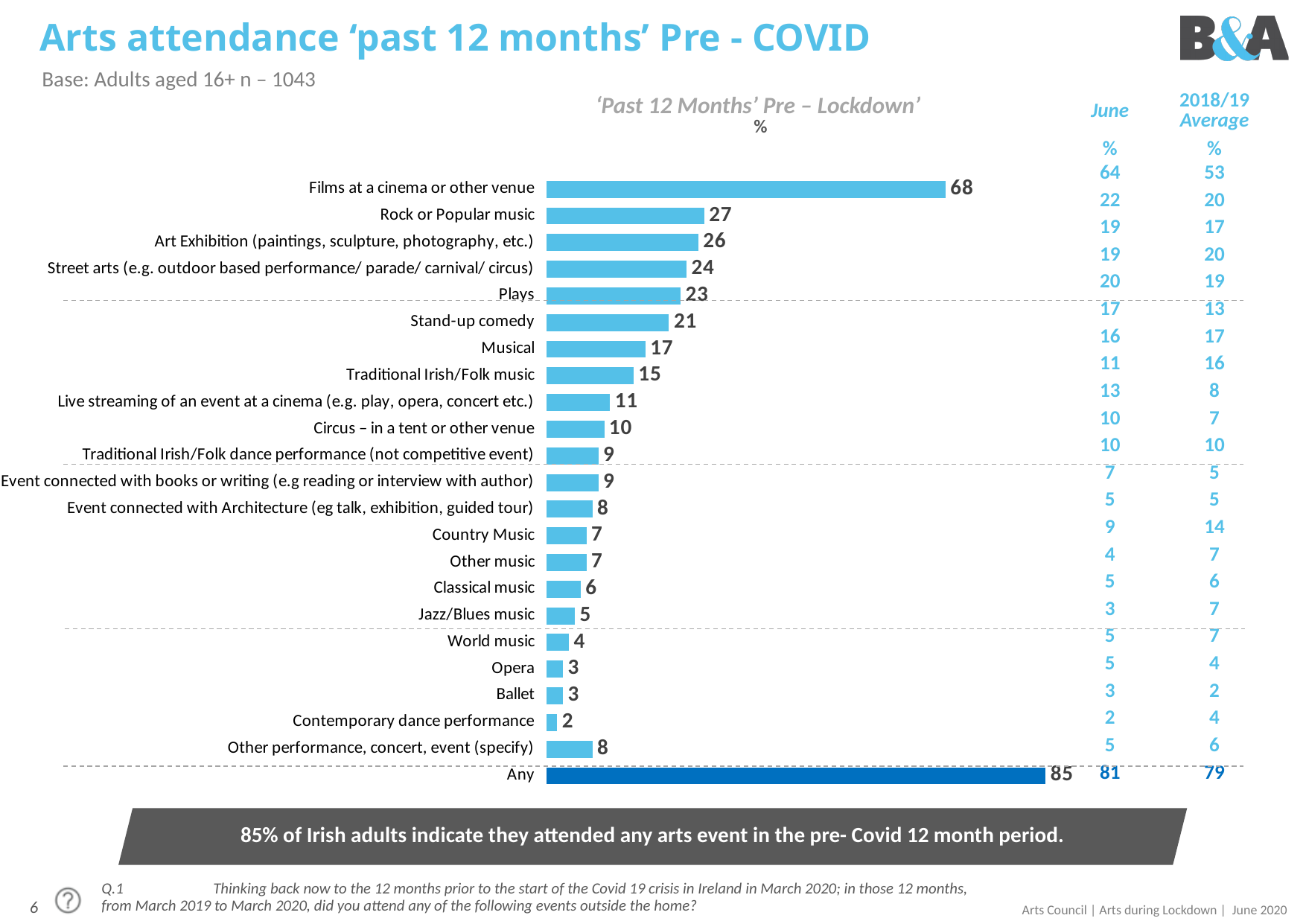
Which has a larger value in the chart, Musical or Traditional Irish/Folk music? Musical Which category has the lowest value in the chart? Contemporary dance performance What is the difference between the values for Rock or Popular music and Plays in the chart? 4 What is the value for Stand-up comedy in the chart? 21 What is the value for Opera in the chart? 3 What type of chart is shown on the slide? Bar chart How many bars are plotted in the chart, including the 'Any' bar? 23 What is the value for the 'Any' bar in the chart? 85 What is the difference between the 'Any' bar and the Films at a cinema or other venue bar? 17 What is the value for Films at a cinema or other venue in the 'Past 12 Months' Pre-Lockdown chart? 68 Excluding the 'Any' bar, which category has the highest value in the chart? Films at a cinema or other venue What is the value for Contemporary dance performance in the chart? 2